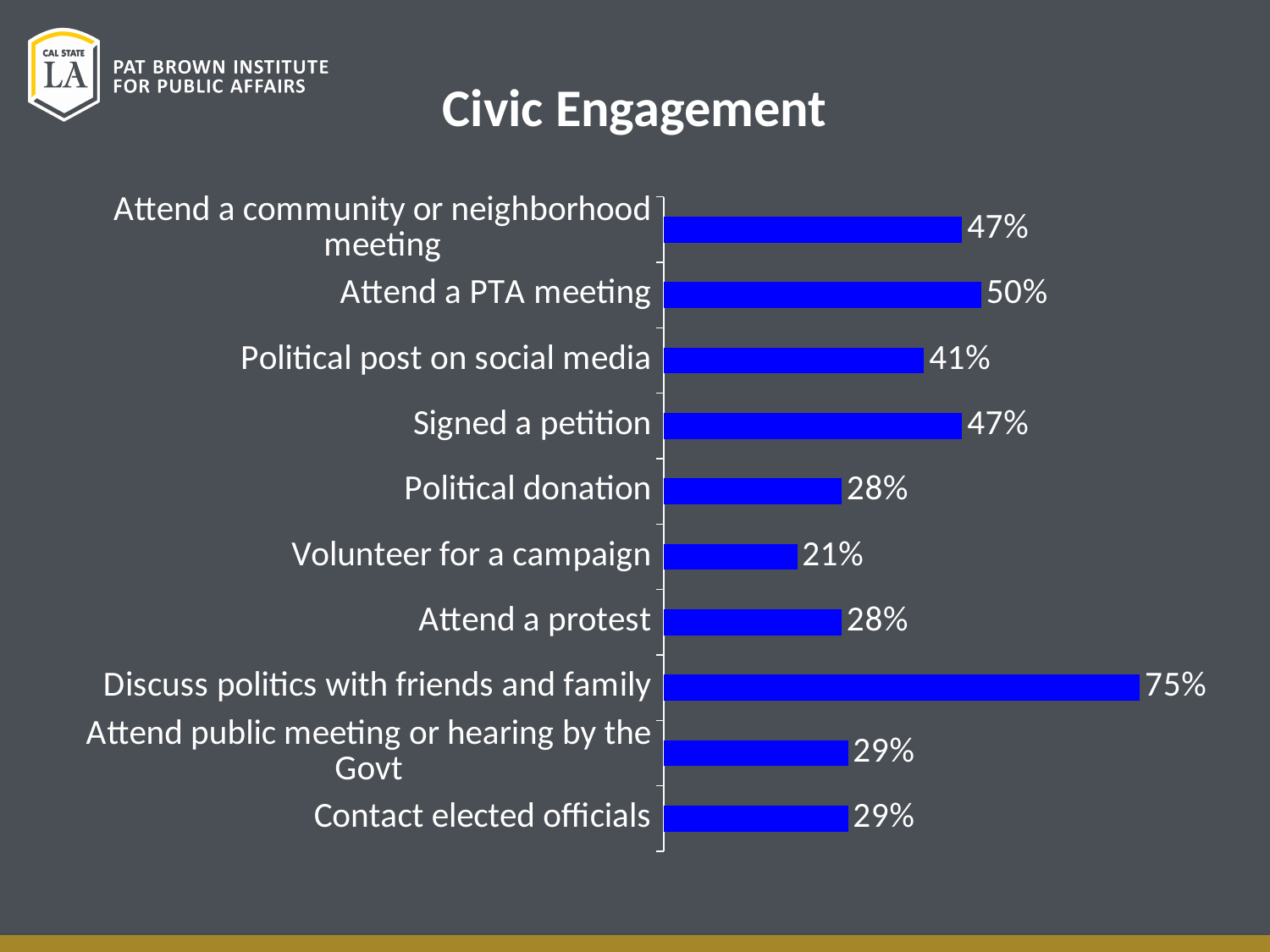
What kind of chart is shown on the slide? Bar chart What is the value for "Volunteer for a campaign"? 21% What is the difference between "Signed a petition" and "Political donation"? 19% What is the difference between "Discuss politics with friends and family" and "Attend a PTA meeting"? 25% Which category has the lowest value? Volunteer for a campaign Which is larger, "Attend a PTA meeting" or "Political post on social media"? Attend a PTA meeting What is the title of the chart? Civic Engagement What is the value for "Political post on social media"? 41% What is the value for "Discuss politics with friends and family"? 75% Which category has the highest value? Discuss politics with friends and family How many categories are shown in the chart? 10 What is the value for "Attend a PTA meeting"? 50%